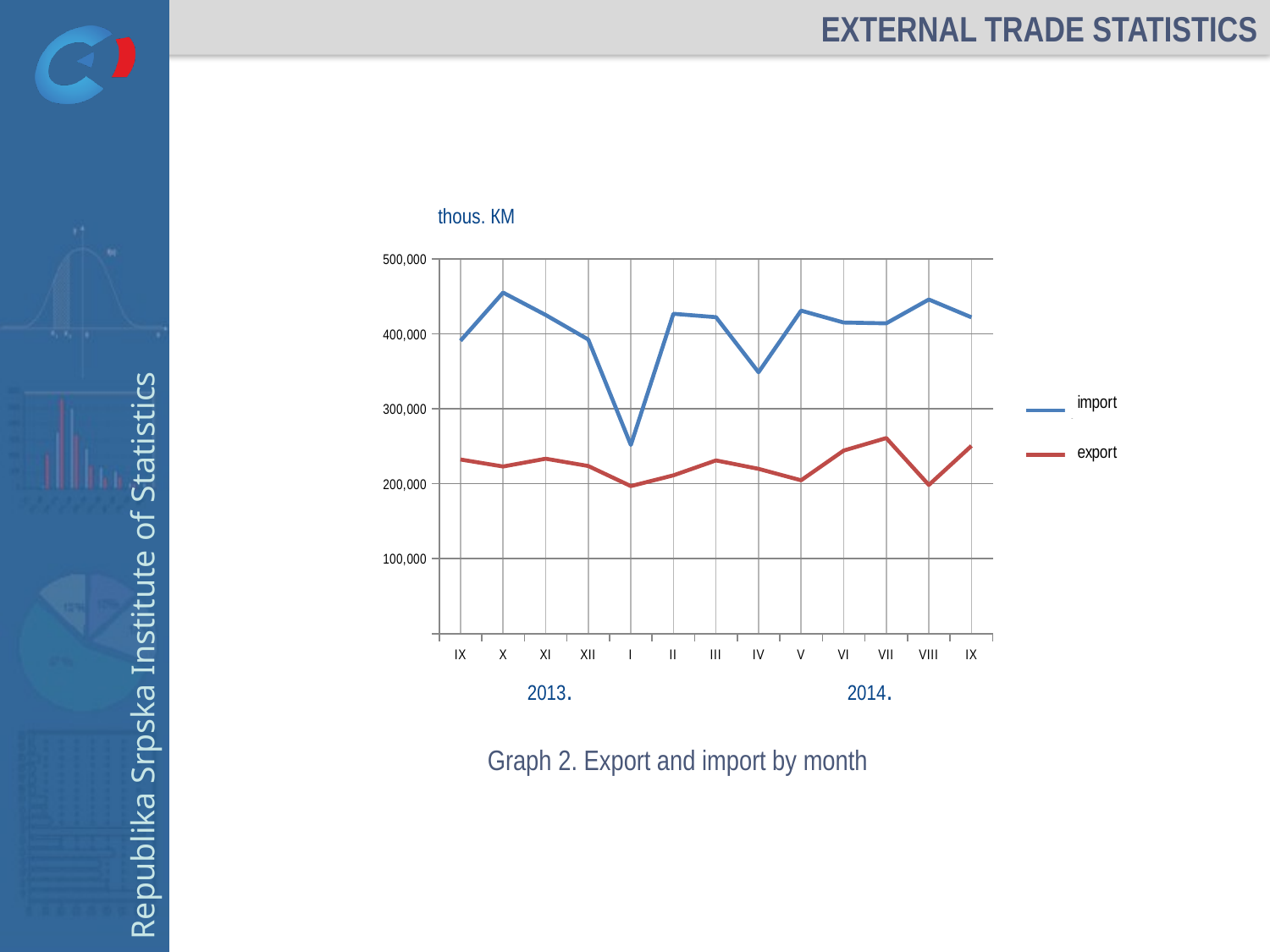
In what unit are the values in Graph 2 expressed? thous. KM How many series does the legend of Graph 2 list? 2 Which is larger in IX 2014, import or export? import Is the import value for IV 2014 greater or less than 400,000? less What kind of chart is Graph 2? line chart In which month is the import value lowest? I 2014 Does the import value rise or fall from XII 2013 to I 2014? fall Is the import value for X 2013 greater or less than 400,000? greater How many months are plotted along the x axis of Graph 2? 13 Is the import value for I 2014 greater or less than 300,000? less Does the export value rise or fall from IV 2014 to VII 2014? rise